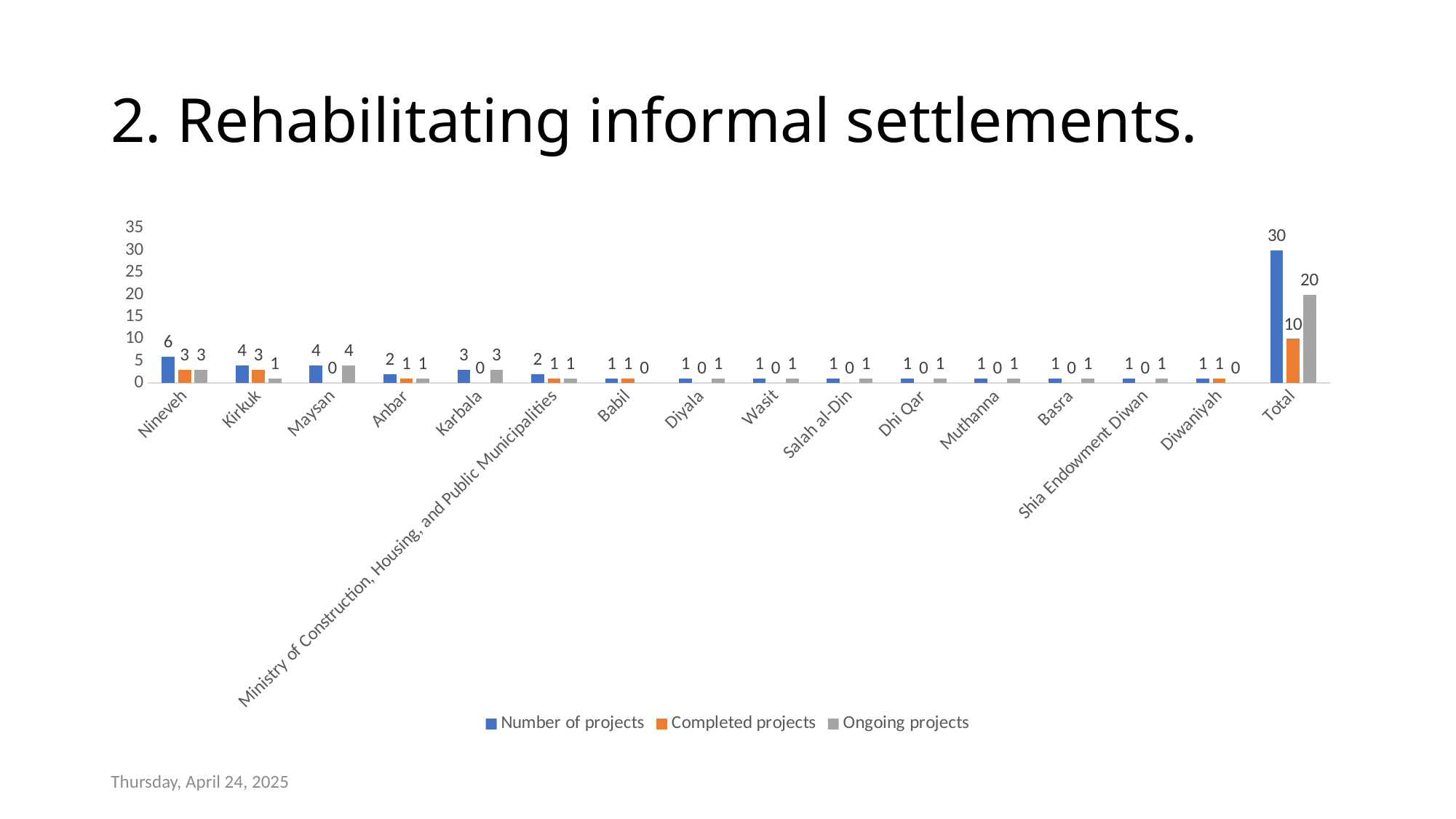
What is the Number of projects for Nineveh? 6 Excluding the Total category, which category has the highest Number of projects? Nineveh What is the Completed projects value for Diwaniyah? 1 How many categories are shown on the x axis? 16 How many series does the legend list? 3 What is the Ongoing projects value for Maysan? 4 What is the Completed projects value for the Total category? 10 Which is larger for Karbala: Completed projects or Ongoing projects? Ongoing projects What is the difference between Number of projects and Ongoing projects for the Total category? 10 Which series is shown in orange in the legend? Completed projects How many Completed projects are shown for Kirkuk? 3 What kind of chart is shown on the slide? Bar chart